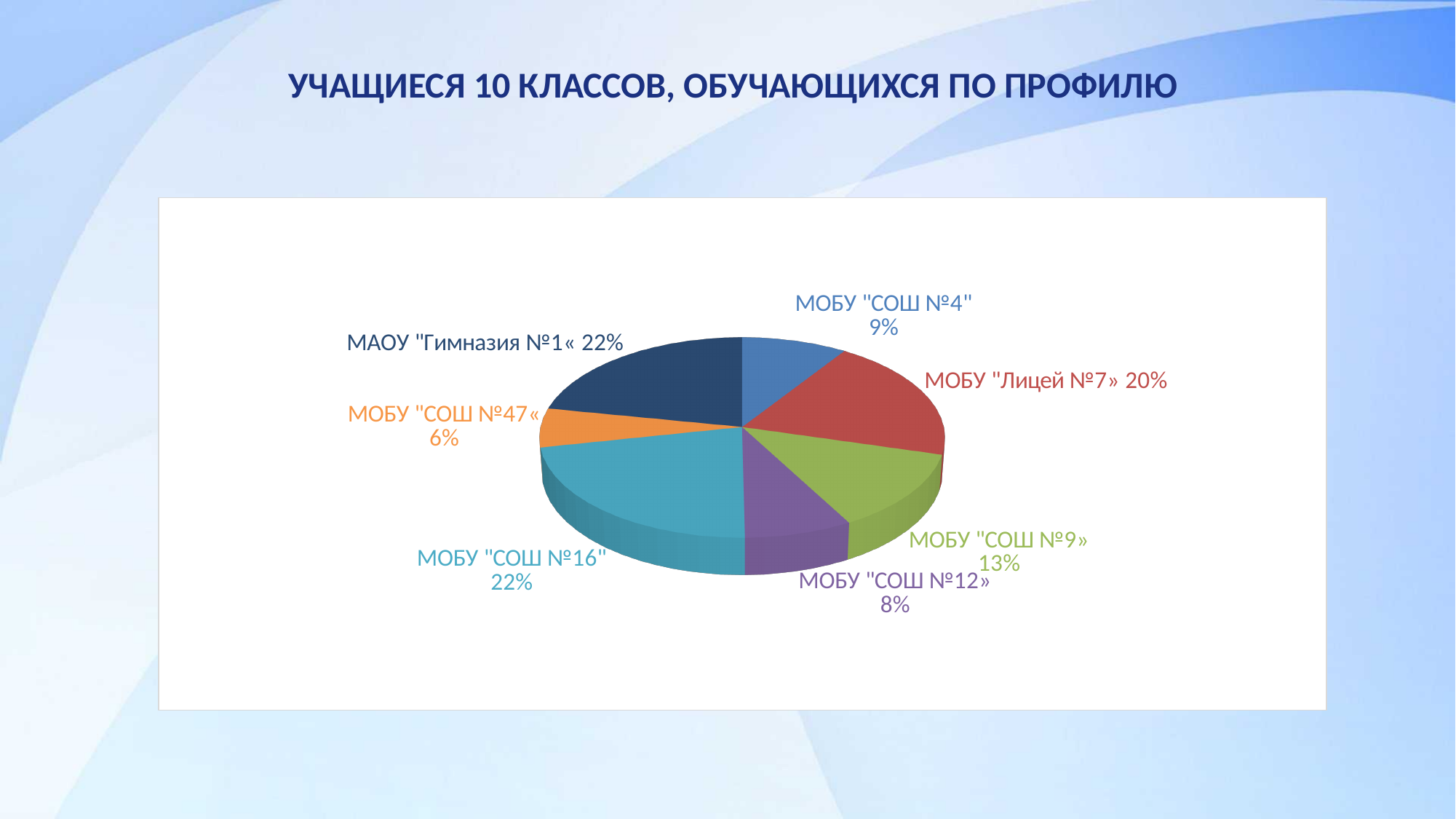
What is the title of the slide? УЧАЩИЕСЯ 10 КЛАССОВ, ОБУЧАЮЩИХСЯ ПО ПРОФИЛЮ What share of the pie does МОБУ "СОШ №9" have? 13% Which school has the smallest slice of the pie? МОБУ "СОШ №47" What is the difference between the shares of МАОУ "Гимназия №1" and МОБУ "СОШ №4"? 13% What share of the pie does МОБУ "Лицей №7" have? 20% What share of the pie does МОБУ "СОШ №12" have? 8% How many slices does the pie chart have? 7 What is the difference between the shares of МОБУ "СОШ №16" and МОБУ "СОШ №12"? 14% Which is larger, the share of МОБУ "Лицей №7" or the share of МОБУ "СОШ №9"? МОБУ "Лицей №7" What kind of chart is shown on the slide? pie chart